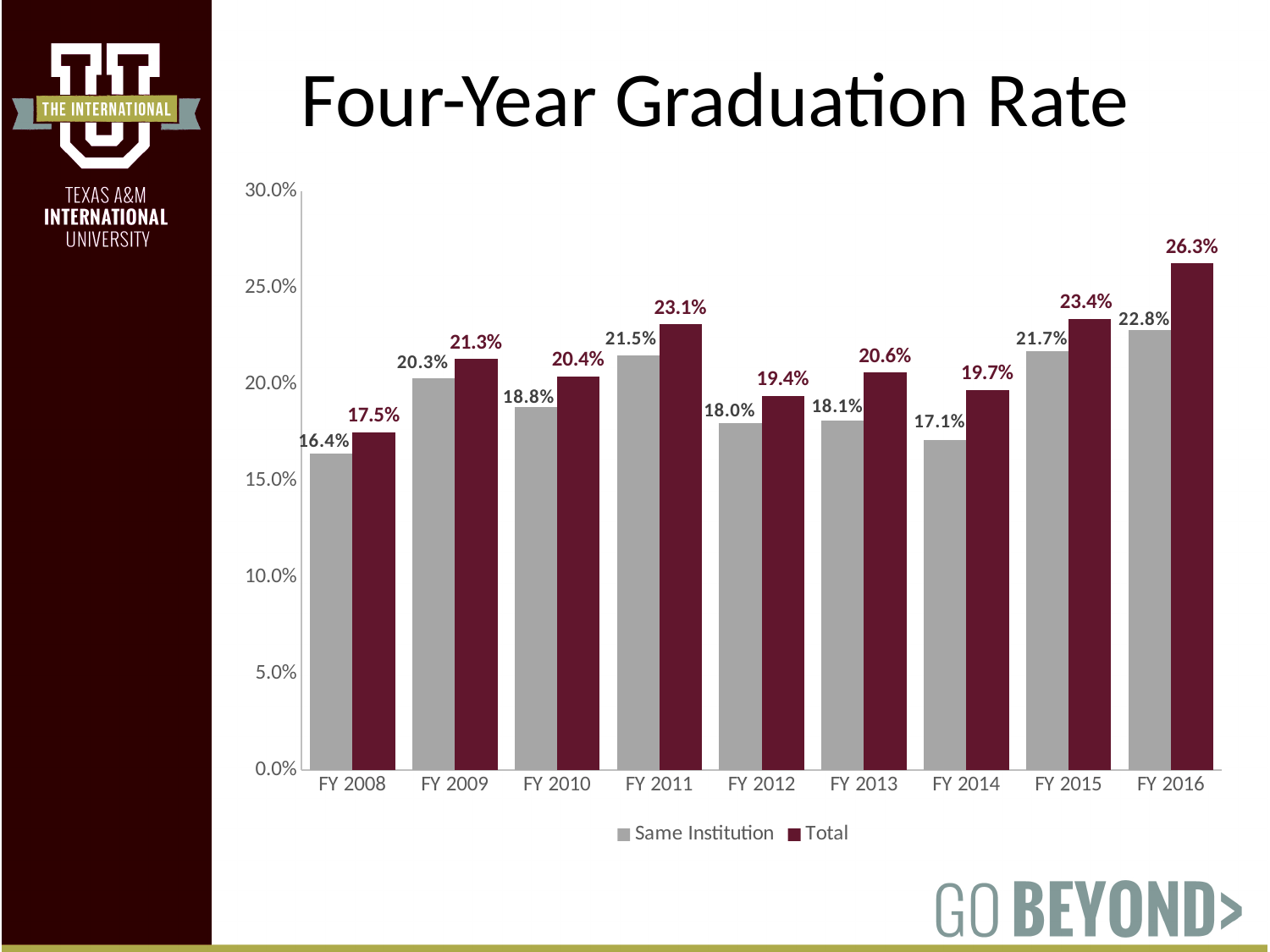
What kind of chart is shown on the slide? Bar chart What is the Total four-year graduation rate for FY 2016? 26.3% Which fiscal year has the highest Total four-year graduation rate? FY 2016 What is the Same Institution value for FY 2014? 17.1% What is the Same Institution four-year graduation rate for FY 2008? 16.4% How many fiscal years are shown on the x axis? 9 Which fiscal year has the lowest Same Institution four-year graduation rate? FY 2008 Is the Total value for FY 2012 greater or less than 20.0%? less Which is larger, the Total rate for FY 2011 or the Total rate for FY 2015? FY 2015 What is the title of the chart? Four-Year Graduation Rate How many series does the legend list? 2 What is the difference between the Total and Same Institution rates for FY 2016? 3.5%